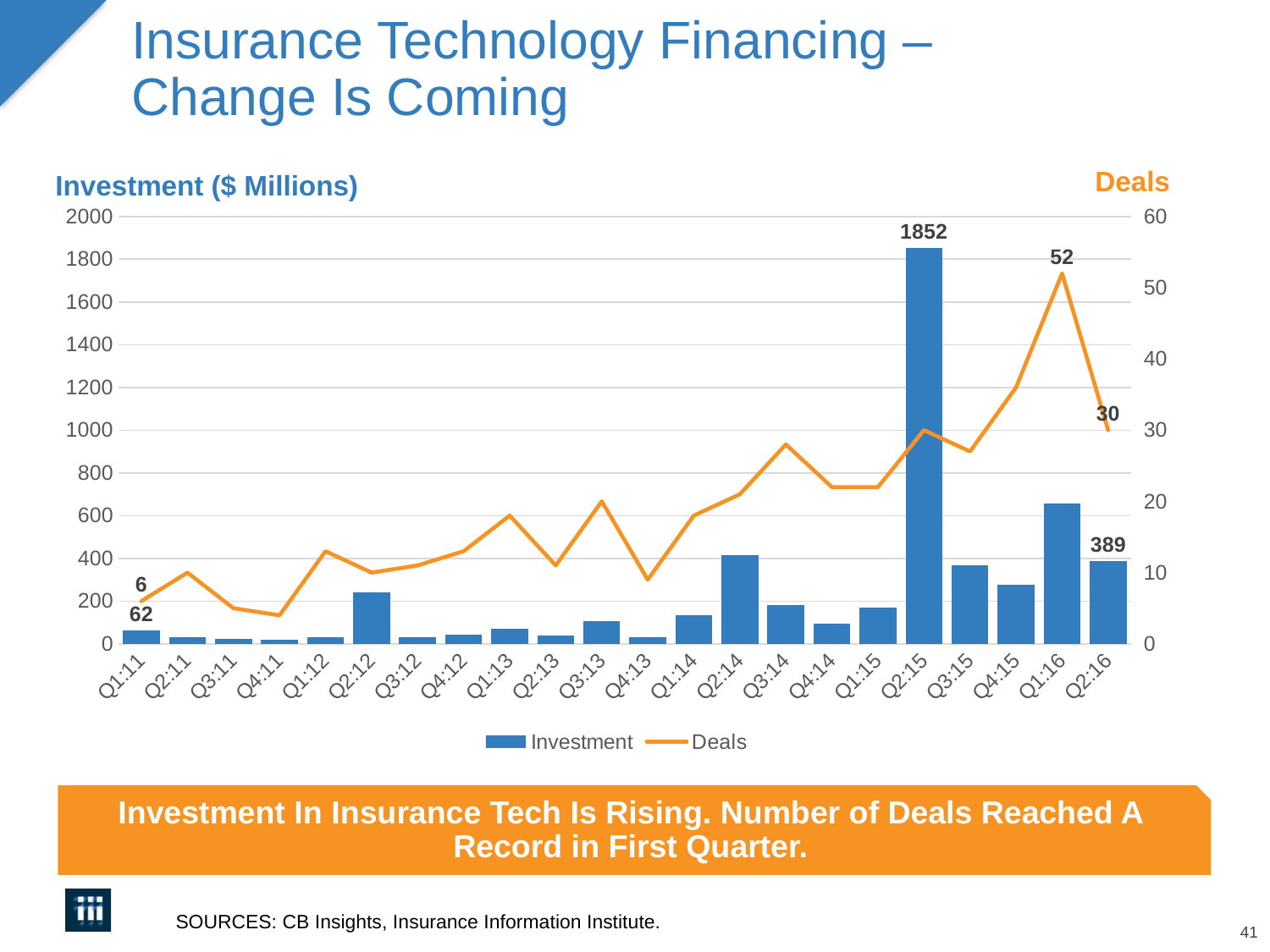
How many quarters are shown on the x axis? 22 What is the Investment value for Q2:15? 1852 What is the number of Deals in Q2:16? 30 What is the difference between the Investment values for Q2:15 and Q2:16? 1463 What is the number of Deals in Q1:16? 52 In which quarter does the Deals line reach its peak? Q1:16 How many series does the legend list? 2 Is the Investment value for Q2:14 greater or less than 200? greater What kind of chart is shown on the slide? Combination bar and line chart Which quarter has the highest Investment bar? Q2:15 What is the Investment value for Q1:11? 62 By how much did the number of Deals fall from Q1:16 to Q2:16? 22